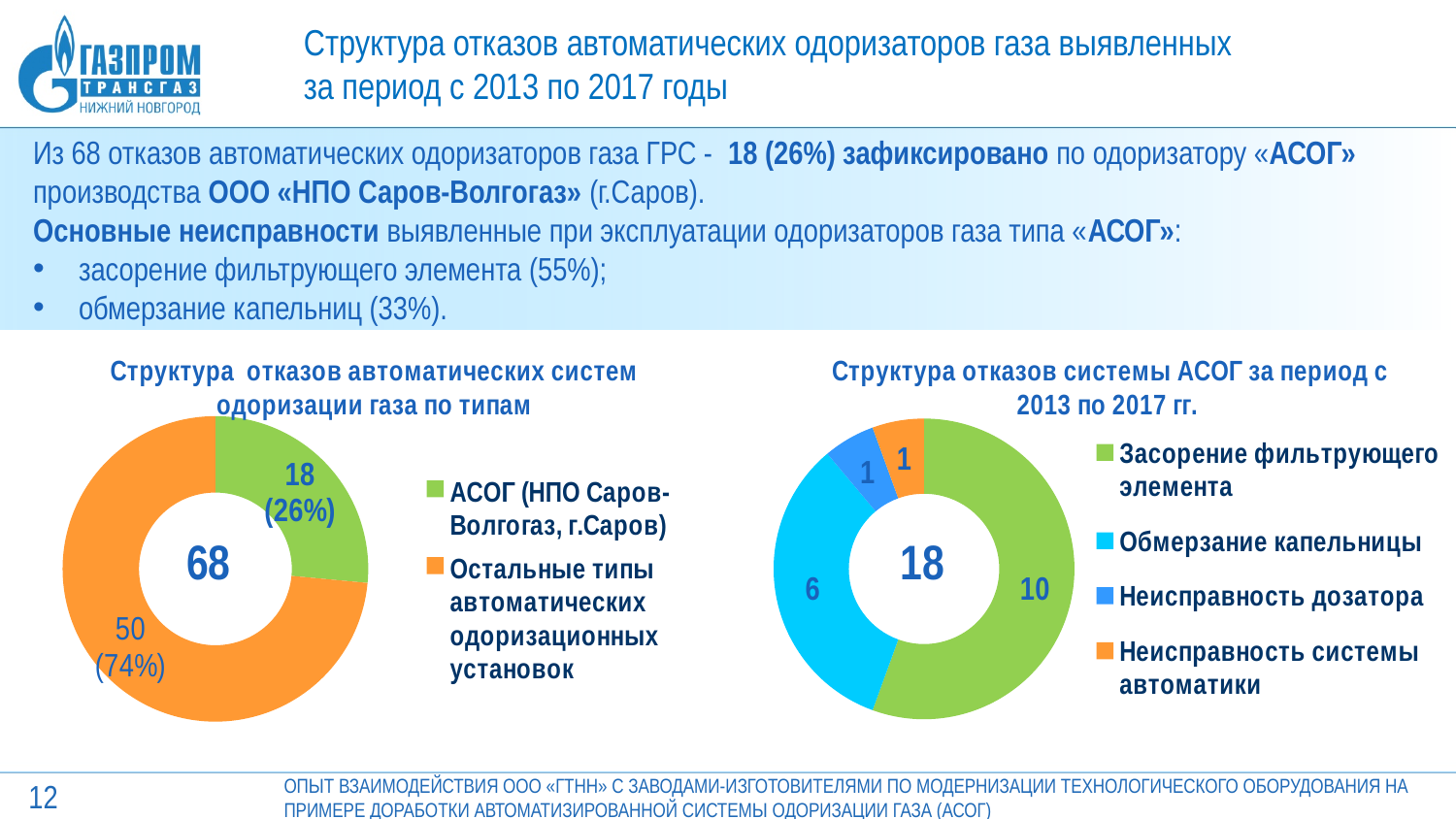
In the chart titled «Структура отказов автоматических систем одоризации газа по типам», what value is shown for «АСОГ (НПО Саров-Волгогаз, г.Саров)»? 18 (26%) How many categories does the legend of the right chart list? 4 In the chart titled «Структура отказов автоматических систем одоризации газа по типам», what value is shown for «Остальные типы автоматических одоризационных установок»? 50 (74%) What type of chart is used on the left side of the slide? Donut (pie) chart In the left chart, what number is printed in the centre of the donut? 68 In the right chart, what is the difference between «Засорение фильтрующего элемента» and «Обмерзание капельницы»? 4 In the right chart, which category has the highest value? Засорение фильтрующего элемента In the right chart, what number is printed in the centre of the donut? 18 In the left chart, what share of failures is attributed to «АСОГ (НПО Саров-Волгогаз, г.Саров)»? 26% In the chart titled «Структура отказов системы АСОГ за период с 2013 по 2017 гг.», what value is shown for «Обмерзание капельницы»? 6 In the left chart, which category has the larger value: «АСОГ» or «Остальные типы автоматических одоризационных установок»? Остальные типы автоматических одоризационных установок In the chart titled «Структура отказов системы АСОГ за период с 2013 по 2017 гг.», what value is shown for «Засорение фильтрующего элемента»? 10